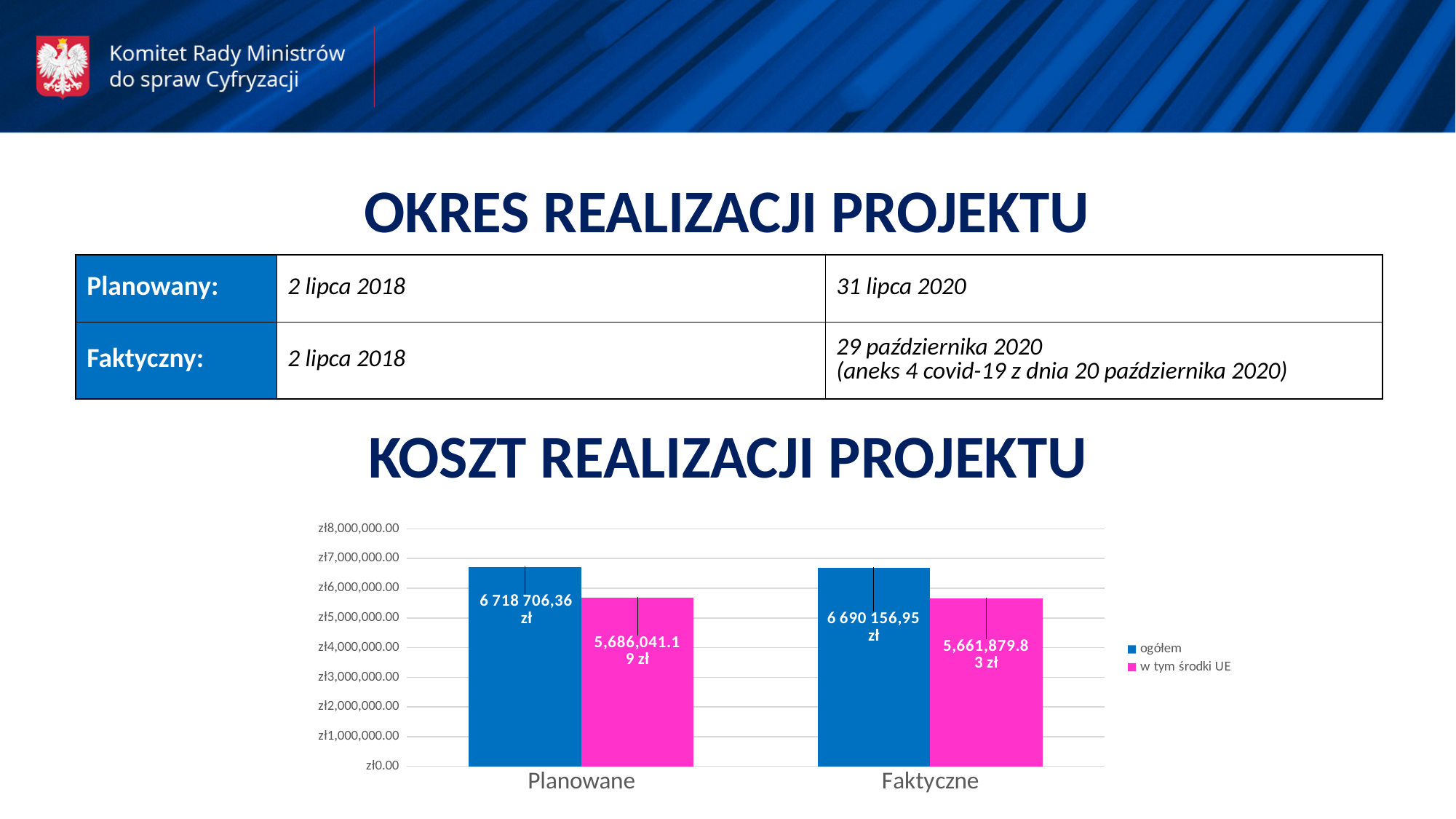
In the KOSZT REALIZACJI PROJEKTU chart, is the value of w tym środki UE for Faktyczne greater or less than zł6,000,000.00? less In the KOSZT REALIZACJI PROJEKTU chart, what is the value of ogółem for Planowane? 6 718 706,36 zł In the KOSZT REALIZACJI PROJEKTU chart, what is the value of w tym środki UE for Faktyczne? 5,661,879.83 zł In the KOSZT REALIZACJI PROJEKTU chart, what is the value of ogółem for Faktyczne? 6 690 156,95 zł In the KOSZT REALIZACJI PROJEKTU chart, what colour are the bars for the series w tym środki UE? pink In the KOSZT REALIZACJI PROJEKTU chart, what is the difference between ogółem for Planowane and ogółem for Faktyczne? 28 549,41 zł How many categories are shown on the x axis of the KOSZT REALIZACJI PROJEKTU chart? 2 How many series does the legend of the KOSZT REALIZACJI PROJEKTU chart list? 2 What type of chart is shown under the title KOSZT REALIZACJI PROJEKTU? bar chart In the KOSZT REALIZACJI PROJEKTU chart, what is the difference between w tym środki UE for Planowane and w tym środki UE for Faktyczne? 24,161.36 zł In the KOSZT REALIZACJI PROJEKTU chart, which is larger: ogółem for Planowane or ogółem for Faktyczne? Planowane In the KOSZT REALIZACJI PROJEKTU chart, what is the value of w tym środki UE for Planowane? 5,686,041.19 zł